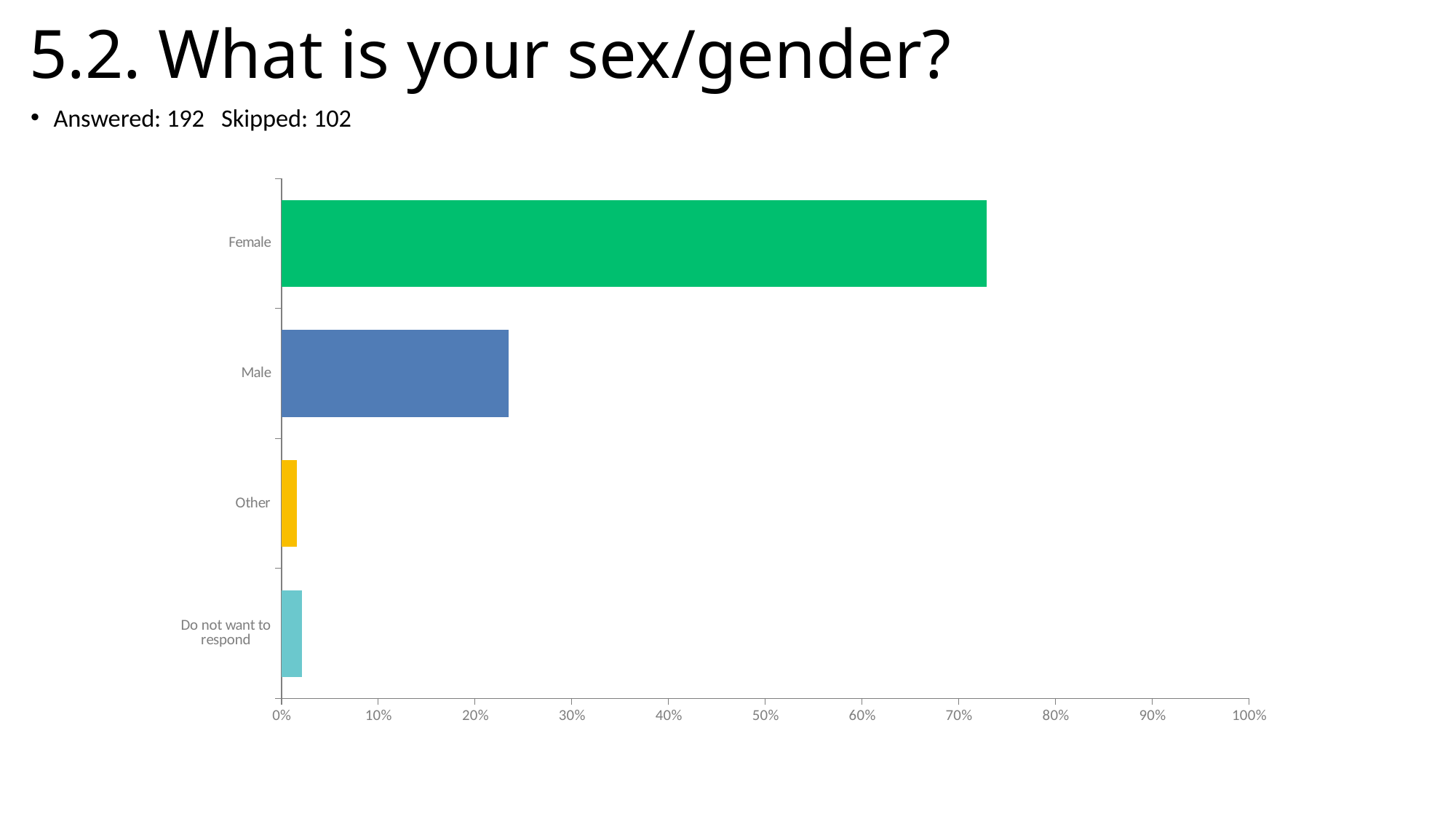
Which is larger, the value for Female or the value for Male? Female Which is larger, the value for Male or the value for Other? Male Is the value for Male greater or less than 30%? less What kind of chart is shown on the slide? bar chart Is the value for Other greater or less than 10%? less What colour is the bar for Female? green What is the maximum value shown on the horizontal axis of the chart? 100% How many categories are shown in the chart? 4 Is the value for Male greater or less than 20%? greater Which category has the highest value in the chart? Female